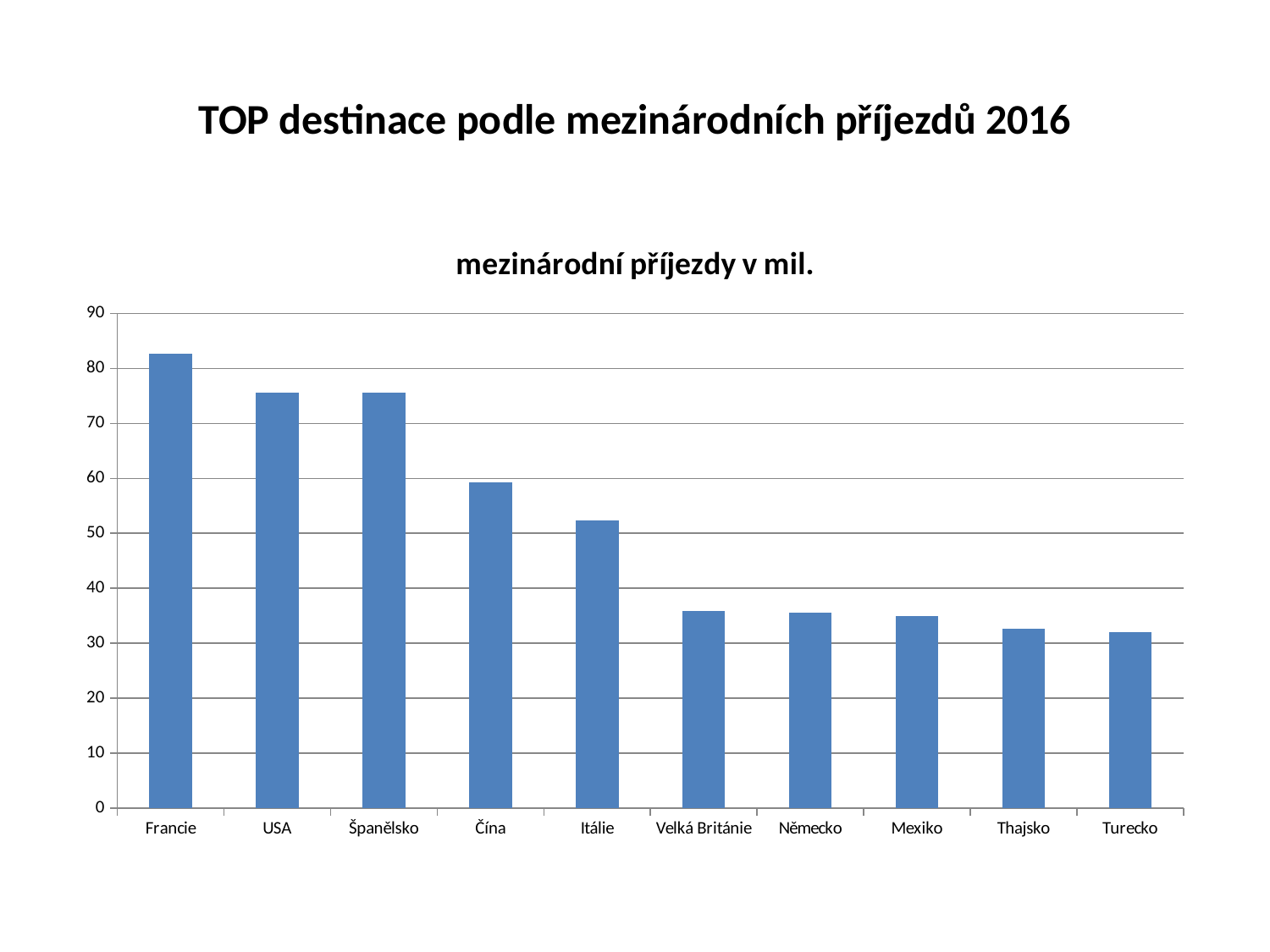
Which has the larger value, Francie or USA? Francie Do the values rise or fall from left to right along the x axis? fall Which has the larger value, Čína or Itálie? Čína How many countries are shown on the x axis of the chart? 10 What is the title of the chart? mezinárodní příjezdy v mil. Is the value for Francie greater or less than 80? greater Is the value for USA greater or less than 70? greater What kind of chart is shown on the slide? bar chart Is the value for Velká Británie greater or less than 40? less Which country has the highest value in the chart? Francie